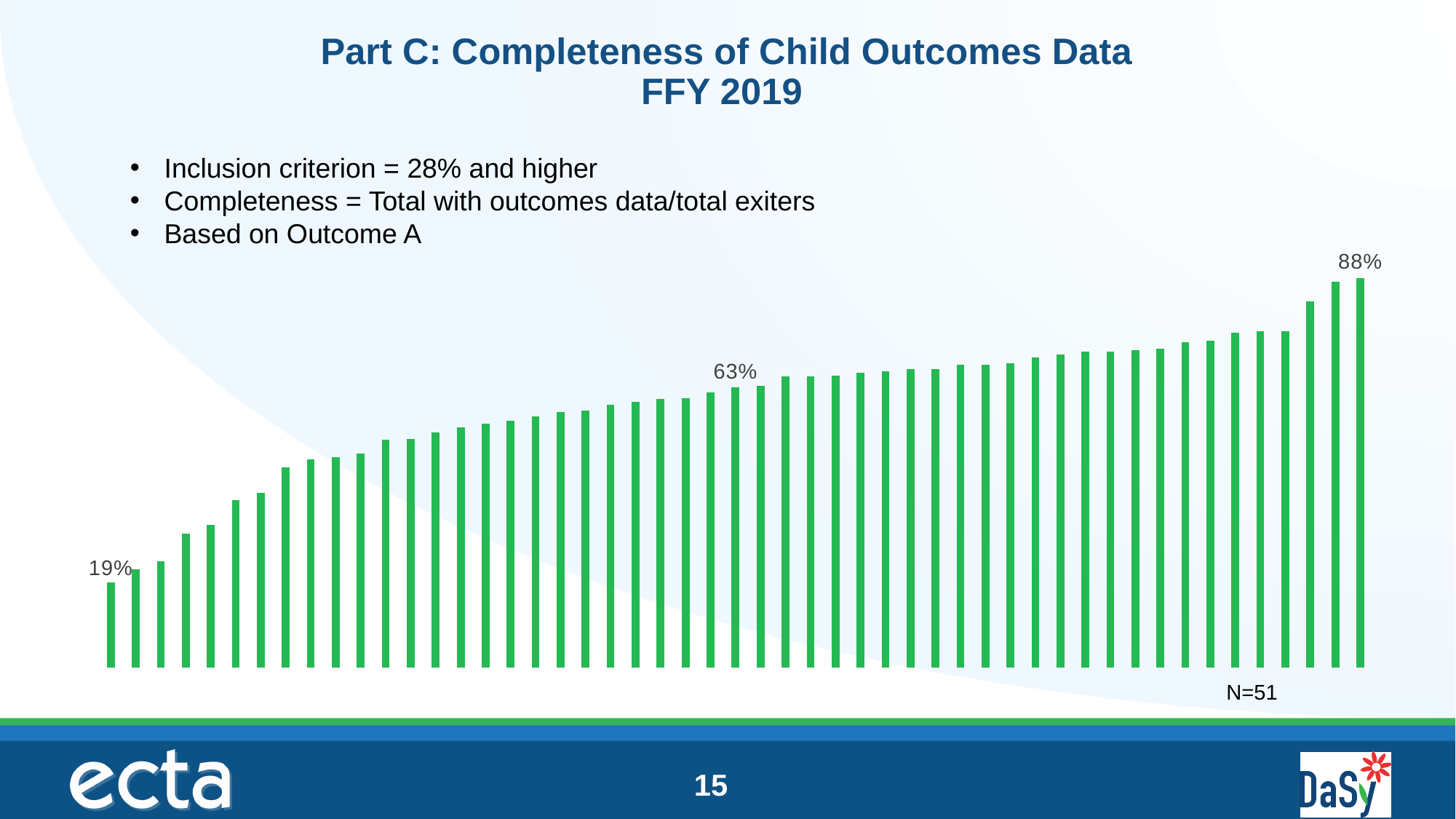
What is the highest value labeled in the chart? 88% What is the difference between the highest labeled value (88%) and the lowest labeled value (19%)? 69 percentage points Do the bar values rise or fall from left to right across the chart? rise What colour are the bars in the chart? green What kind of chart is shown on the slide? bar chart What is the lowest value labeled in the chart? 19% What is the difference between the middle labeled value (63%) and the lowest labeled value (19%)? 44 percentage points How many bars (states/entities) does the chart include, according to the N label? 51 What is the value of the rightmost (tallest) bar in the chart? 88% What is the value of the leftmost (shortest) bar in the chart? 19% Which is larger, the leftmost bar or the rightmost bar? the rightmost bar What value is labeled on the bar in the middle of the chart? 63%